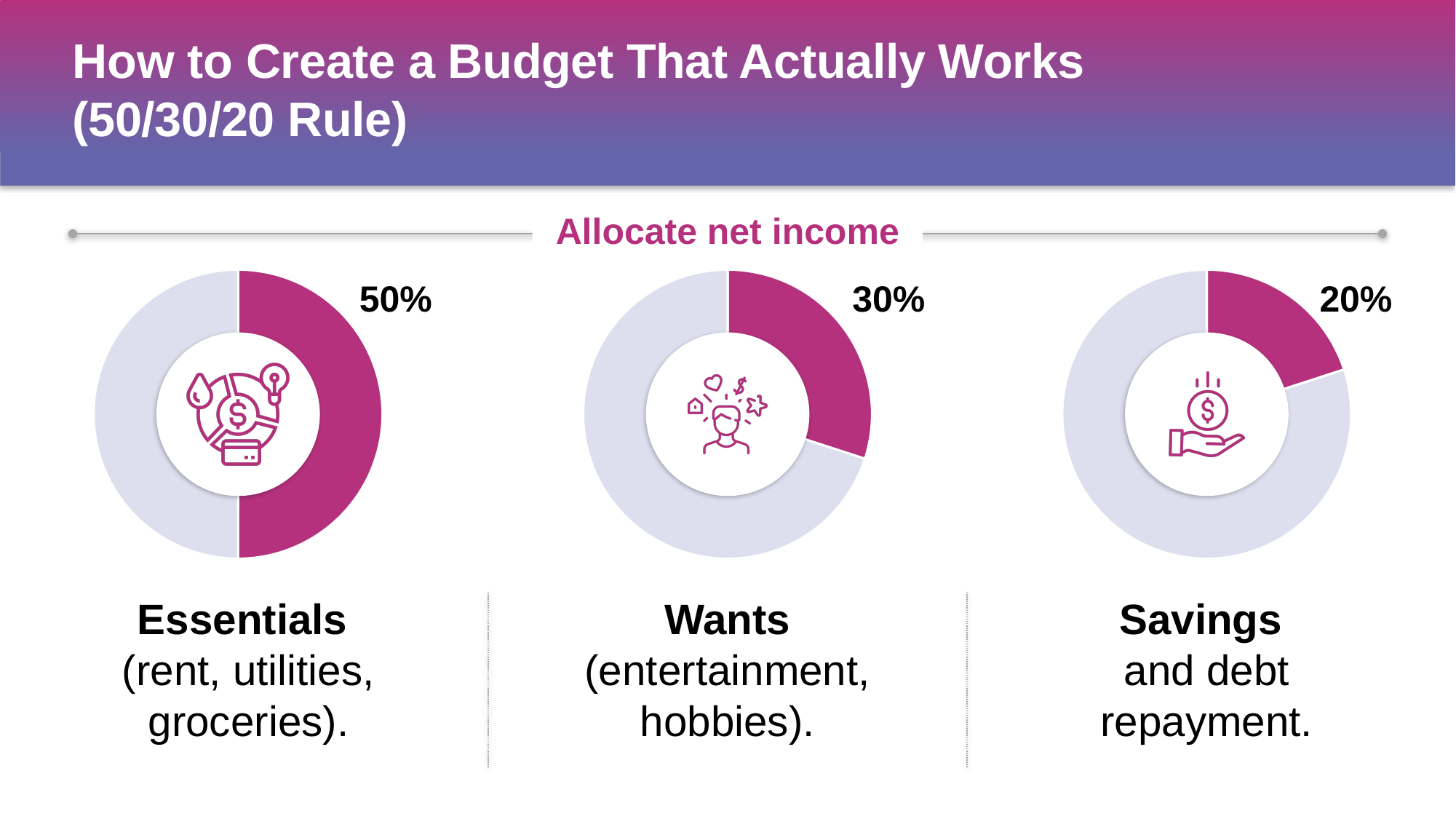
What is the difference between the Essentials share and the Wants share shown on the slide? 20% What is the heading printed above the three donut charts? Allocate net income What is the difference between the Wants share and the Savings share shown on the slide? 10% What kind of chart is used to show each allocation on the slide? Donut chart Across the three donut charts, which category receives the smallest share of net income? Savings Across the three donut charts, which category receives the largest share of net income? Essentials Which is larger, the share for Wants or the share for Savings? Wants How many donut charts are shown on the slide? 3 In the left donut chart, what share of the ring is highlighted in magenta? 50% What percentage of net income is allocated to Savings and debt repayment in the right donut chart? 20% What percentage of net income is allocated to Essentials in the left donut chart? 50% What percentage of net income is allocated to Wants in the middle donut chart? 30%